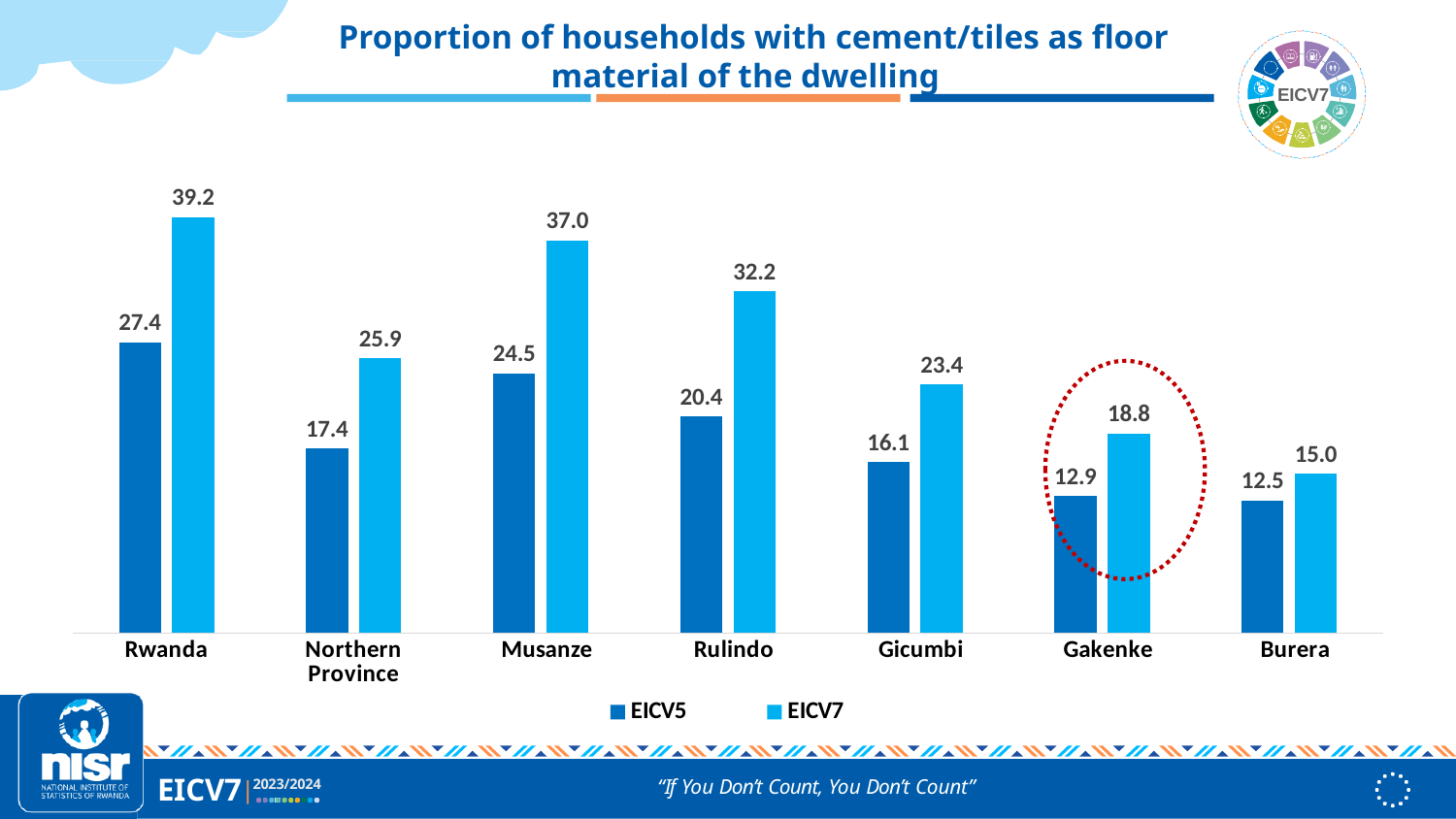
What is the EICV7 value for Musanze? 37.0 What is the difference between the EICV7 and EICV5 values for Rulindo? 11.8 How many series does the legend list? 2 How many categories are shown on the x axis? 7 What is the EICV7 value for Gakenke? 18.8 Which is larger: the EICV7 value for Northern Province or the EICV5 value for Rwanda? EICV5 value for Rwanda What is the title of the chart? Proportion of households with cement/tiles as floor material of the dwelling Which category has the lowest EICV5 value? Burera What is the EICV5 value for Gicumbi? 16.1 Which category is highlighted with a red dotted circle? Gakenke What kind of chart is shown on the slide? Bar chart Which category has the highest EICV7 value? Rwanda